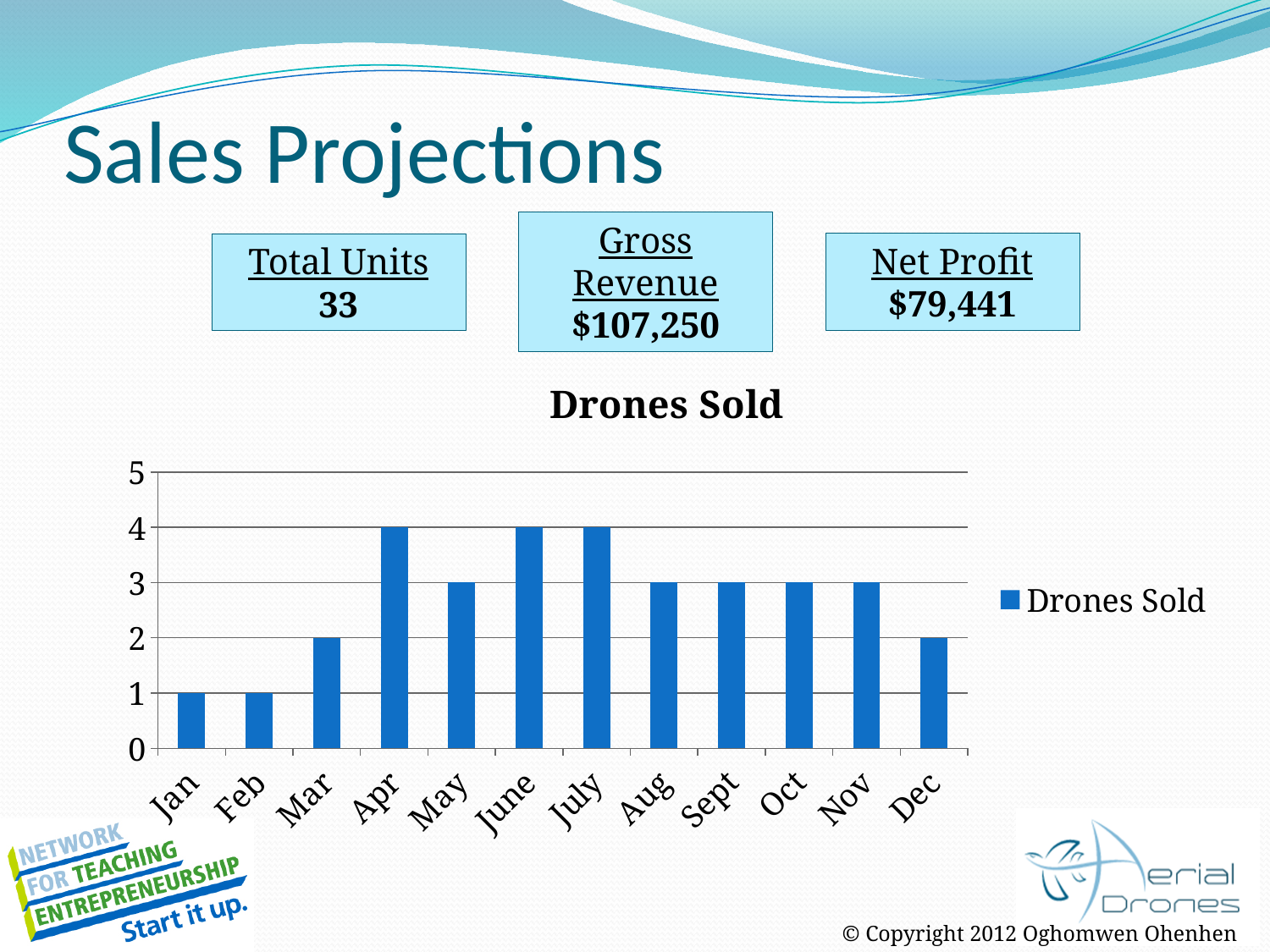
How many series does the legend of the Drones Sold chart list? 1 What kind of chart is shown on the slide? bar chart How many drones are sold in Apr according to the chart? 4 How many drones are sold in Dec according to the chart? 2 How many drones are sold in Mar according to the chart? 2 How many drones are sold in Sept according to the chart? 3 Do the drones sold rise or fall from Jan to Apr? rise What is the chart's title? Drones Sold Which month has more drones sold, Apr or Dec? Apr How many months are plotted on the x axis of the Drones Sold chart? 12 What is the difference between the drones sold in Apr and in Mar? 2 What is the highest number of drones sold in any month on the chart? 4